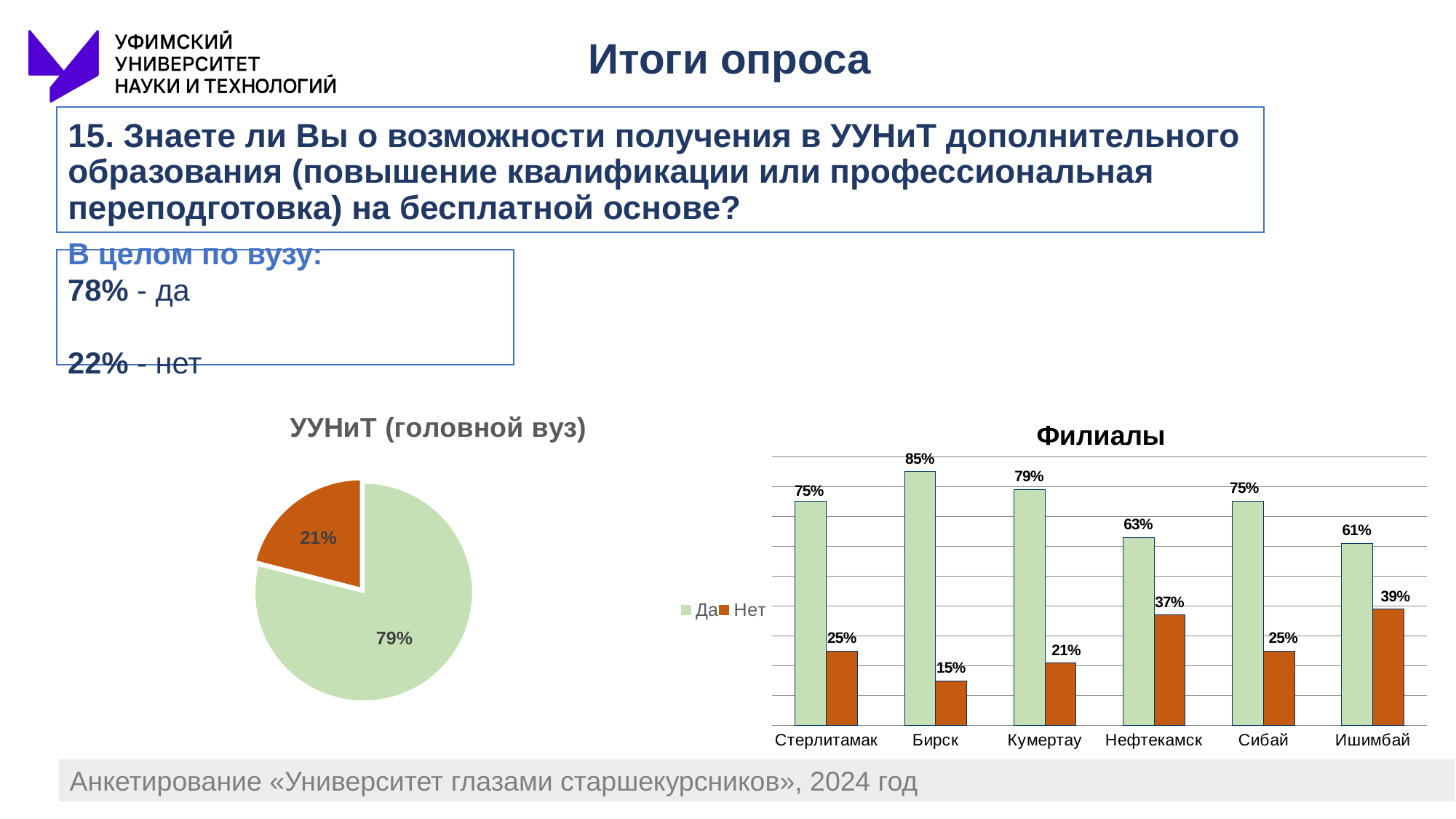
How many series does the legend of the 'Филиалы' chart list? 2 In the 'Филиалы' chart, which is larger: the 'Нет' value for Ишимбай or for Сибай? Ишимбай How many branches are shown on the x axis of the 'Филиалы' chart? 6 In the 'Филиалы' chart, which branch has the highest 'Да' value? Бирск In the 'Филиалы' chart, what is the 'Нет' value for Нефтекамск? 37% In the 'Филиалы' chart, what is the 'Да' value for Бирск? 85% In the 'Филиалы' chart, which branch has the lowest 'Нет' value? Бирск In the 'Филиалы' chart, what is the total of the 'Да' and 'Нет' values for Стерлитамак? 100% In the 'УУНиТ (головной вуз)' pie chart, what share does the larger slice have? 79% What kind of chart is the 'УУНиТ (головной вуз)' chart? pie chart In the 'Филиалы' chart, what is the difference between the 'Да' values for Кумертау and Ишимбай? 18% What kind of chart is the 'Филиалы' chart? bar chart